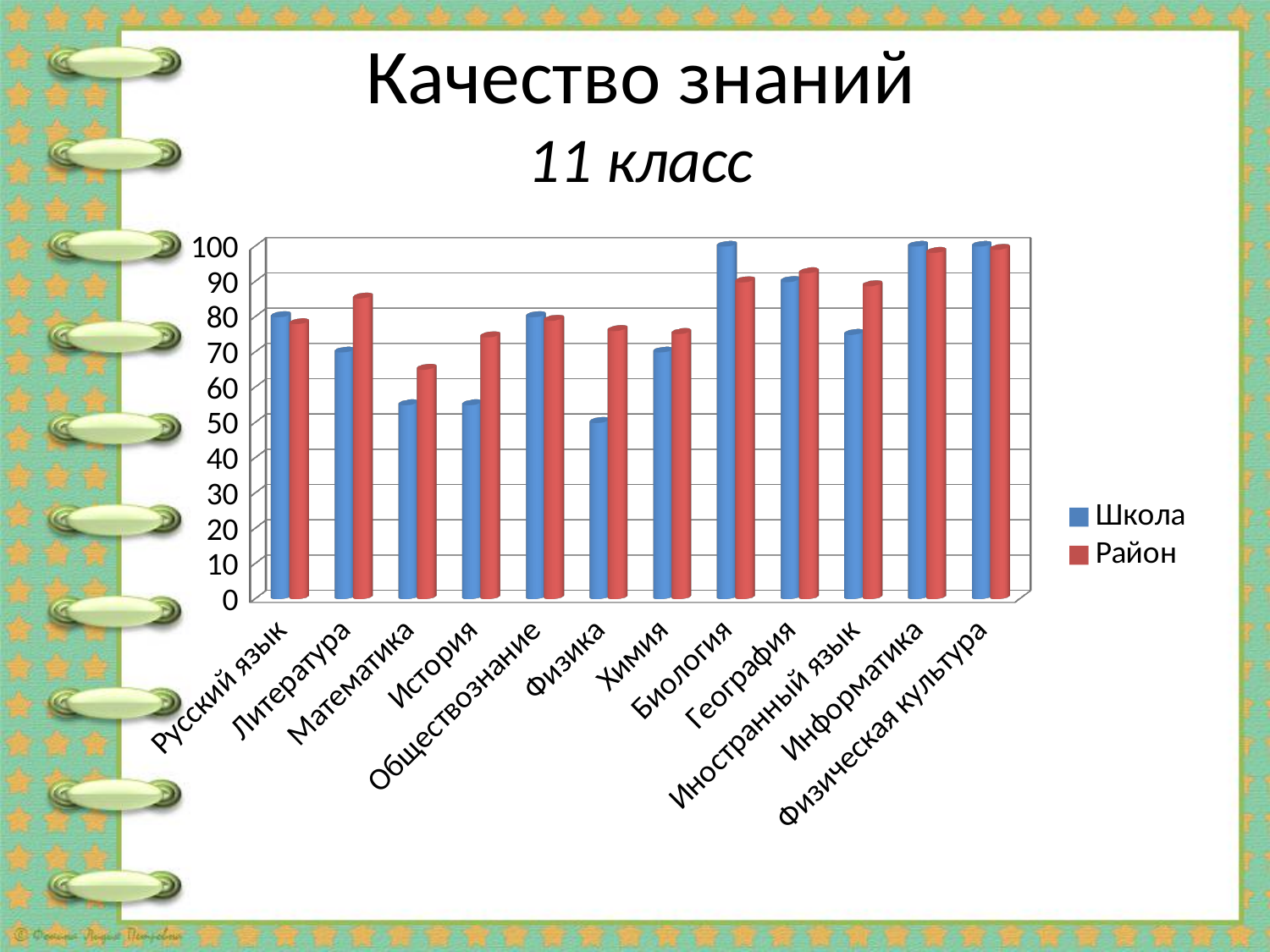
How many series does the chart legend list? 2 What kind of chart is shown on the slide? bar chart What is the value for Школа in Биология? 100 Which subject has the lowest value for Школа? Физика In Биология, which is larger: the value for Школа or for Район? Школа Which subject has the lowest value for Район? Математика Is the value for Школа in Физика greater or less than 60? less In Литература, which is larger: the value for Школа or for Район? Район How many subjects (categories) are shown on the x axis of the chart? 12 What are the two series named in the chart legend? Школа and Район What is the value for Школа in Информатика? 100 Is the value for Район in Иностранный язык greater or less than 80? greater